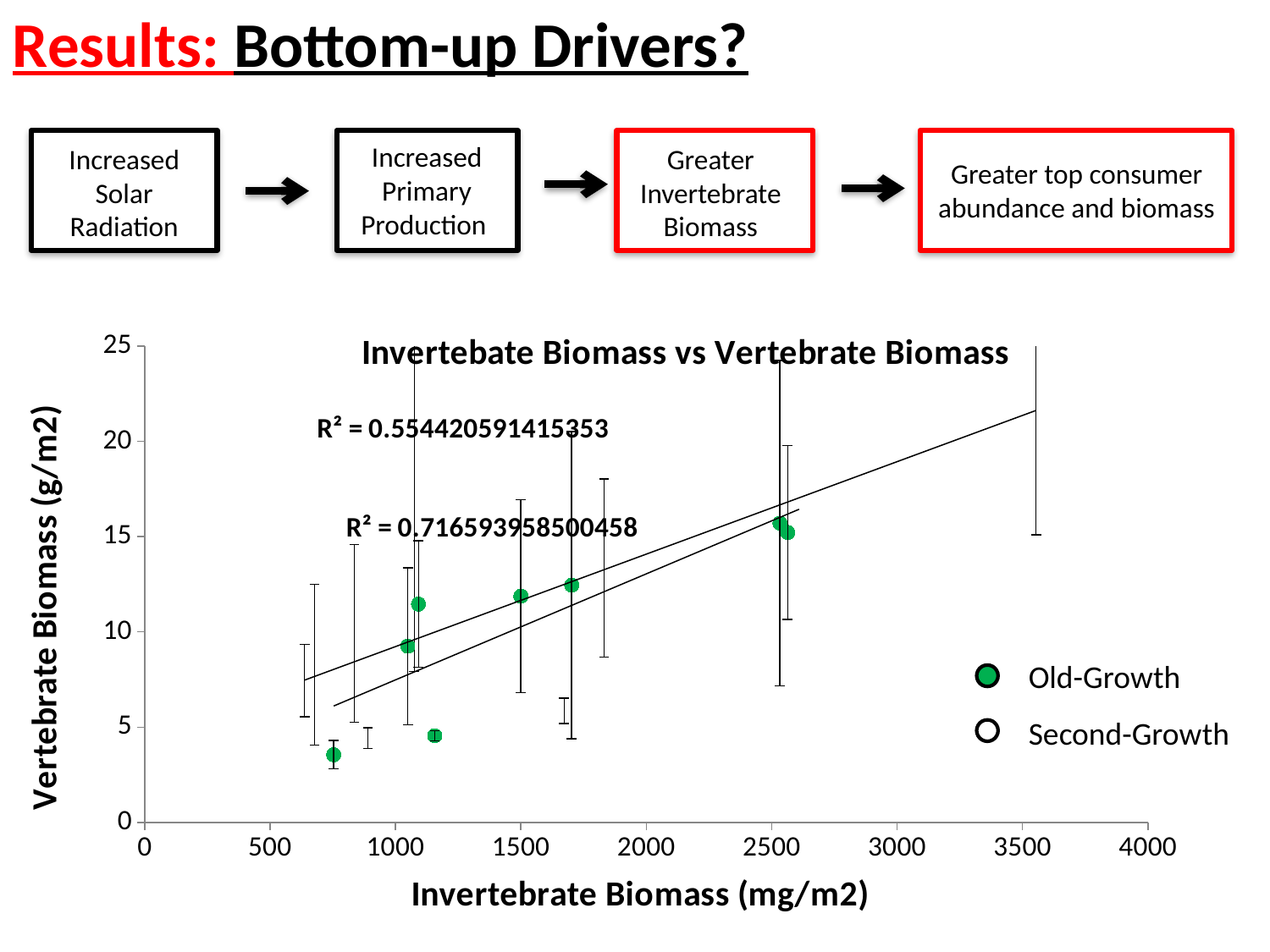
What is the smaller R² value printed on the chart? R² = 0.554420591415353 Is the vertebrate biomass for the Old-Growth point at about 1500 mg/m2 invertebrate biomass greater or less than 15? less What are the two series named in the chart legend? Old-Growth and Second-Growth What kind of chart is shown on the slide? scatter chart Which Old-Growth point has the highest vertebrate biomass: the one near 750 mg/m2 or the one near 2550 mg/m2 invertebrate biomass? the one near 2550 mg/m2 Is the vertebrate biomass for the Old-Growth point at about 750 mg/m2 invertebrate biomass greater or less than 5? less Is the vertebrate biomass for the Old-Growth point at about 1700 mg/m2 invertebrate biomass greater or less than 10? greater What is the larger R² value printed on the chart? R² = 0.716593958500458 What is the title of the chart? Invertebate Biomass vs Vertebrate Biomass What is the maximum value shown on the x axis of the chart? 4000 How many series does the chart legend list? 2 Does vertebrate biomass rise or fall as invertebrate biomass increases along the x axis? rise